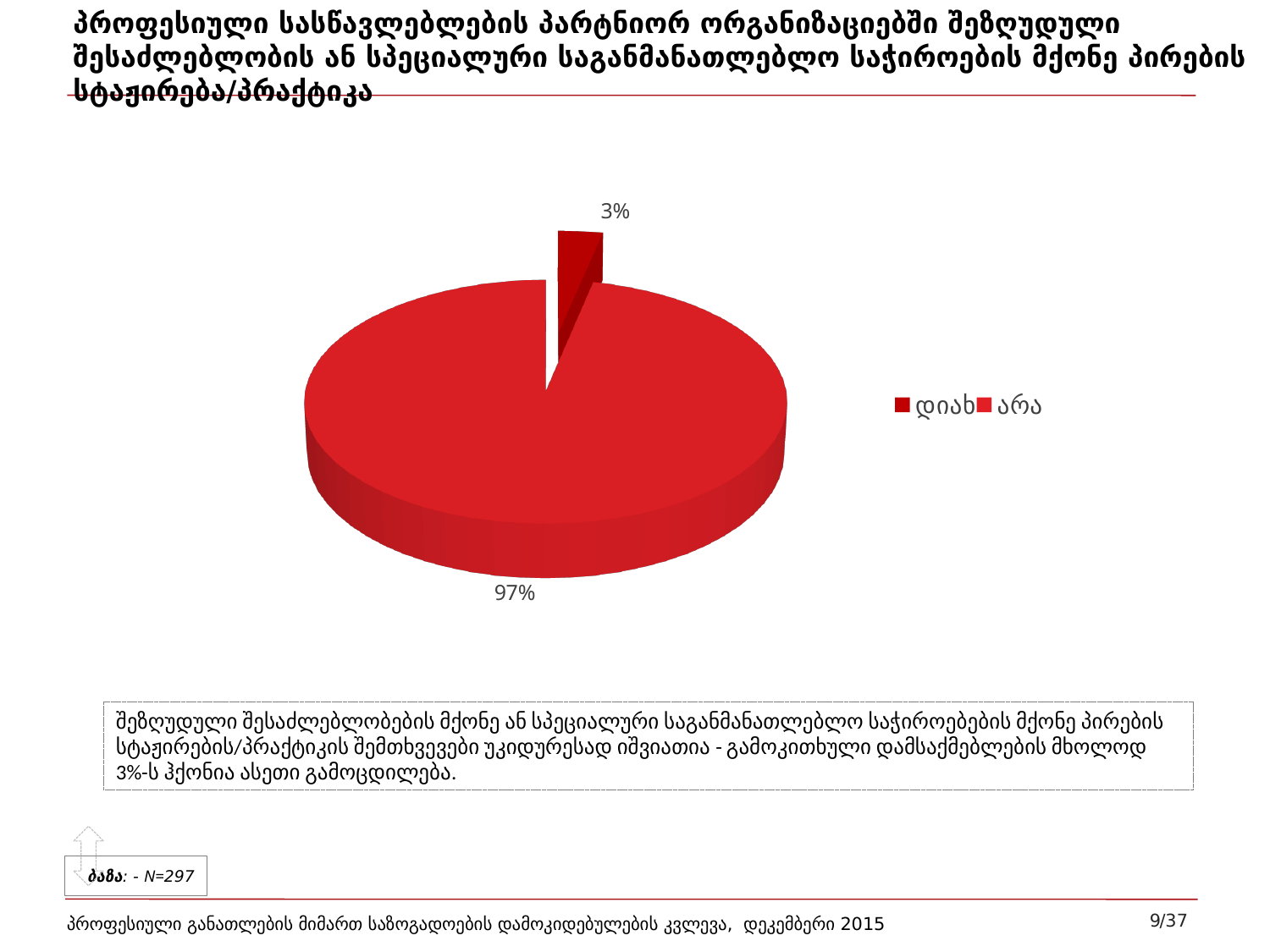
What is the difference in percentage points between the "არა" and "დიახ" slices? 94 What are the two legend entries of the pie chart? დიახ, არა Which is larger, the "დიახ" slice or the "არა" slice? არა Which slice is the smallest in the pie chart? დიახ What sample size (N) is stated on the slide? N=297 What kind of chart is shown on the slide? pie chart How many entries does the legend list? 2 What share of the pie does the "არა" slice take? 97% What percentage does the "არა" slice represent? 97% What percentage does the "დიახ" slice represent? 3% How many slices does the pie chart have? 2 Which slice is the largest in the pie chart? არა